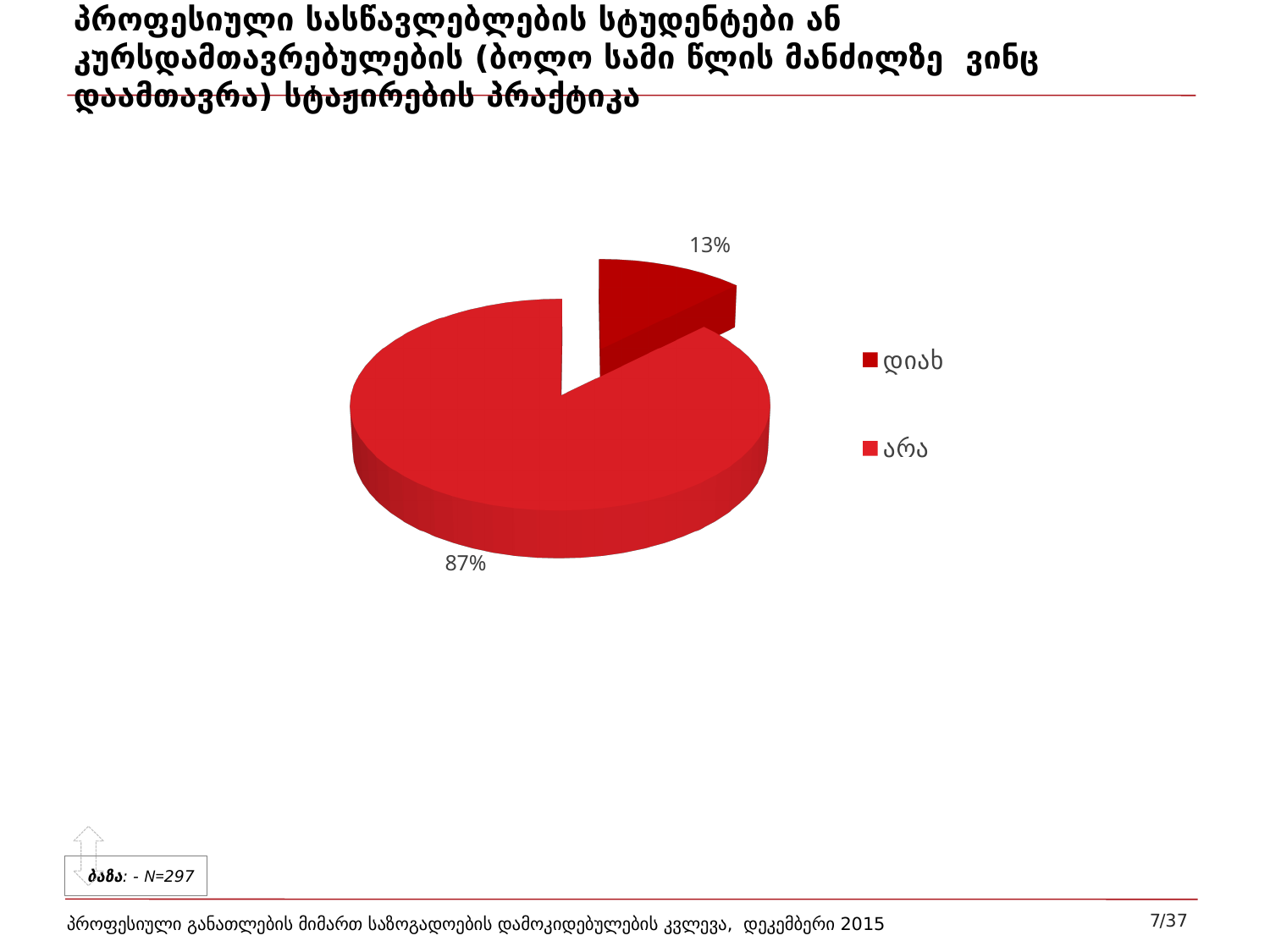
What is the difference in percentage points between the "არა" slice and the "დიახ" slice? 74 Which legend entry is shown in the darker red colour? დიახ What percentage of the pie chart is labelled "დიახ"? 13% What is the sample size (N) stated in the base note on the slide? N=297 Which slice of the pie chart is the largest? არა What share of the pie does the "დიახ" slice represent? 13% What percentage of the pie chart is labelled "არა"? 87% Which is larger in the pie chart, "დიახ" or "არა"? არა How many entries does the legend of the chart list? 2 How many slices does the pie chart have? 2 What kind of chart is shown on the slide? pie chart Which slice of the pie chart is the smallest? დიახ